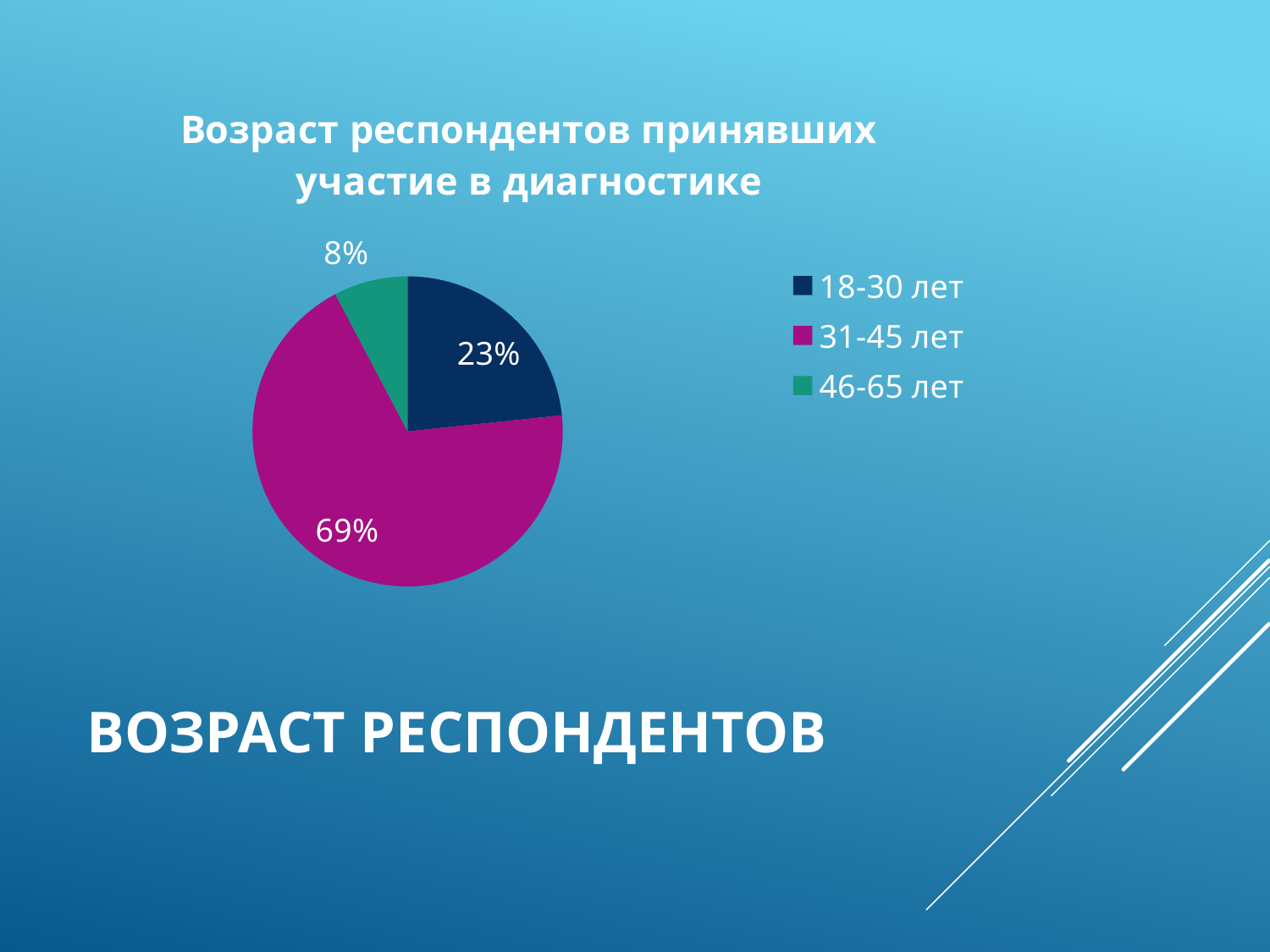
What is the difference in percentage points between the 18-30 лет and 46-65 лет groups? 15 What is the title of the chart? Возраст респондентов принявших участие в диагностике What colour is the slice for 31-45 лет? Magenta Which group has a larger share: 18-30 лет or 46-65 лет? 18-30 лет What is the difference in percentage points between the 31-45 лет and 18-30 лет groups? 46 Which age group has the smallest share of respondents? 46-65 лет How many age groups are shown in the pie chart? 3 What kind of chart is shown on the slide? Pie chart What share of respondents are aged 31-45 лет? 69% Which age group has the largest share of respondents? 31-45 лет What share of respondents are aged 46-65 лет? 8% What share of respondents are aged 18-30 лет? 23%